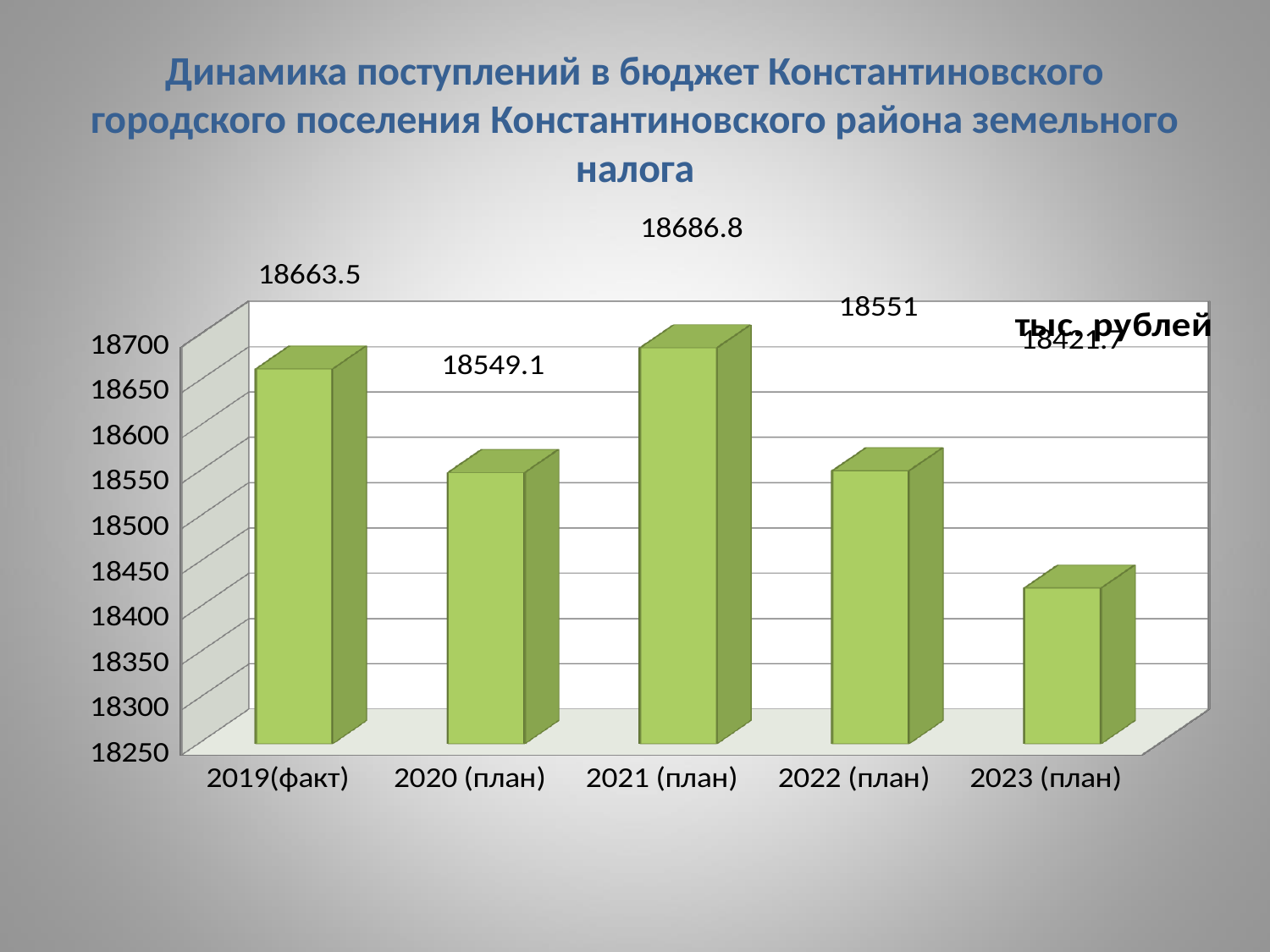
Which year has the lowest value? 2023 (план) What is the value for 2021 (план)? 18686.8 What is the value for 2023 (план)? 18421.7 What is the difference between the values for 2021 (план) and 2019(факт)? 23.3 How many years are shown on the x axis? 5 What is the value for 2019(факт)? 18663.5 Which is larger, the value for 2019(факт) or the value for 2023 (план)? 2019(факт) What kind of chart is shown on the slide? bar chart What is the difference between the values for 2019(факт) and 2023 (план)? 241.8 Is the value for 2023 (план) greater or less than 18450? less What is the value for 2020 (план)? 18549.1 Which year has the highest value? 2021 (план)